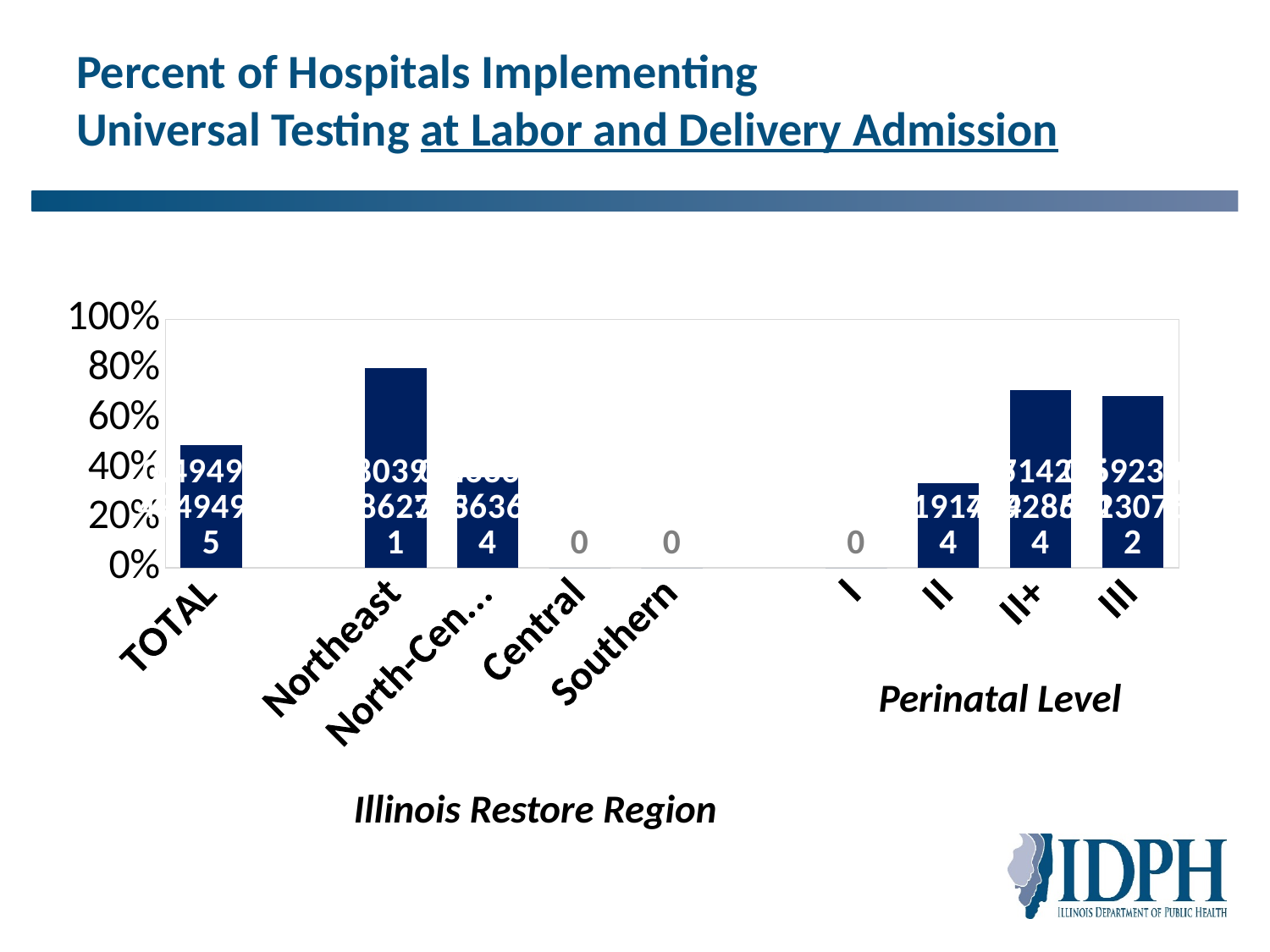
Which is larger, the value for Northeast or the value for TOTAL? Northeast What is the value shown for Southern? 0 What is the value shown for Central? 0 Is the value for perinatal level II+ greater or less than 60%? greater Is the value for Northeast greater or less than 60%? greater What is the label of the x-axis group on the right side of the chart? Perinatal Level Which is larger, the value for perinatal level II+ or the value for perinatal level II? II+ What is the value shown for perinatal level I? 0 Is the value for TOTAL greater or less than 60%? less Which category has the highest bar? Northeast What kind of chart is shown on the slide? bar chart